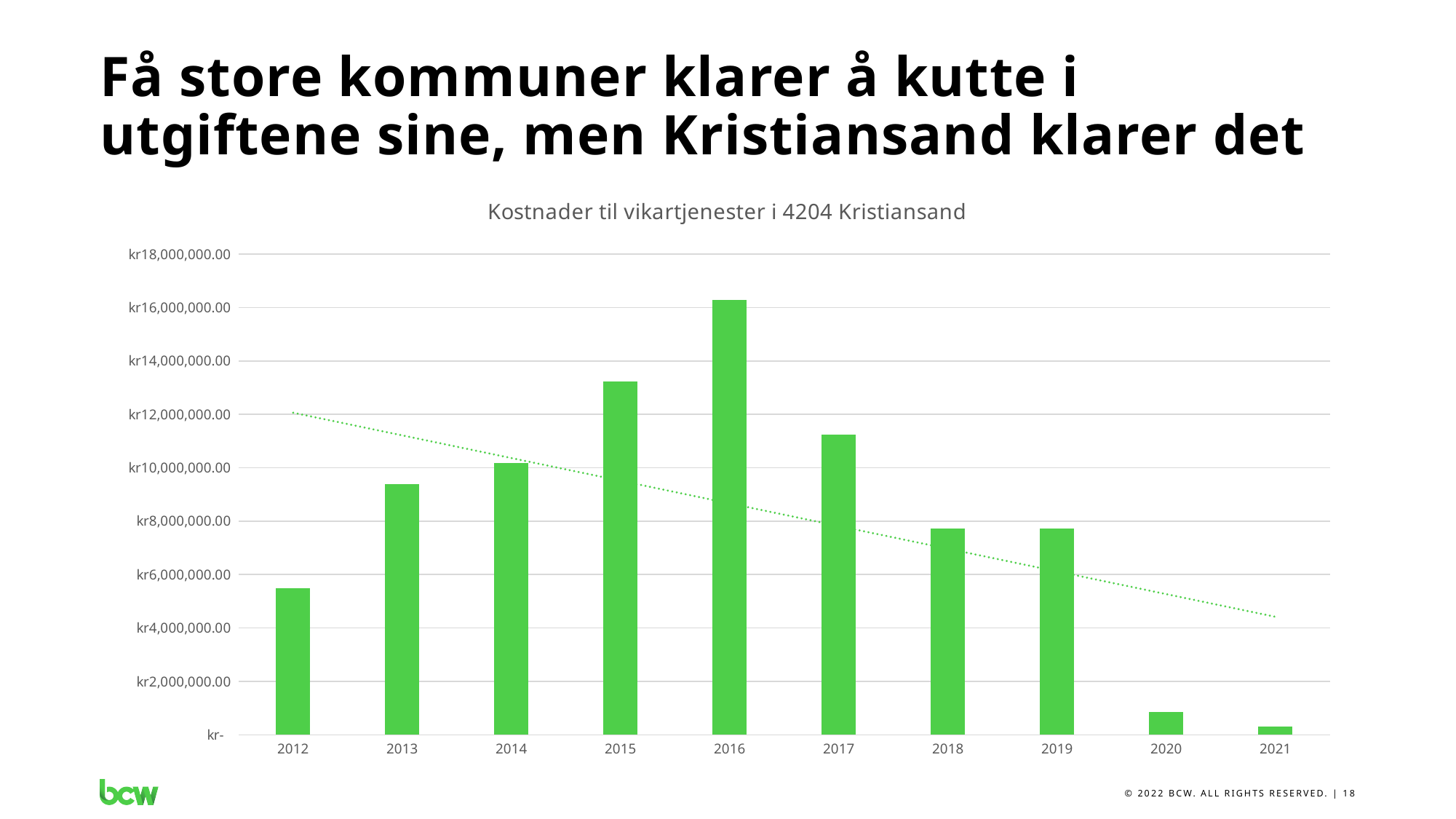
How many years are shown on the x axis of the chart? 10 Is the value for 2012 greater or less than kr6,000,000.00? less Is the value for 2016 greater or less than kr14,000,000.00? greater Which is larger, the value for 2014 or the value for 2017? 2017 Is the value for 2020 greater or less than kr2,000,000.00? less According to the dotted trend line, do the values generally rise or fall from 2012 to 2021? fall Which year has the lowest value in the chart? 2021 Which year has the highest value in the chart? 2016 What kind of chart is shown on the slide? Bar chart What is the title of the chart? Kostnader til vikartjenester i 4204 Kristiansand